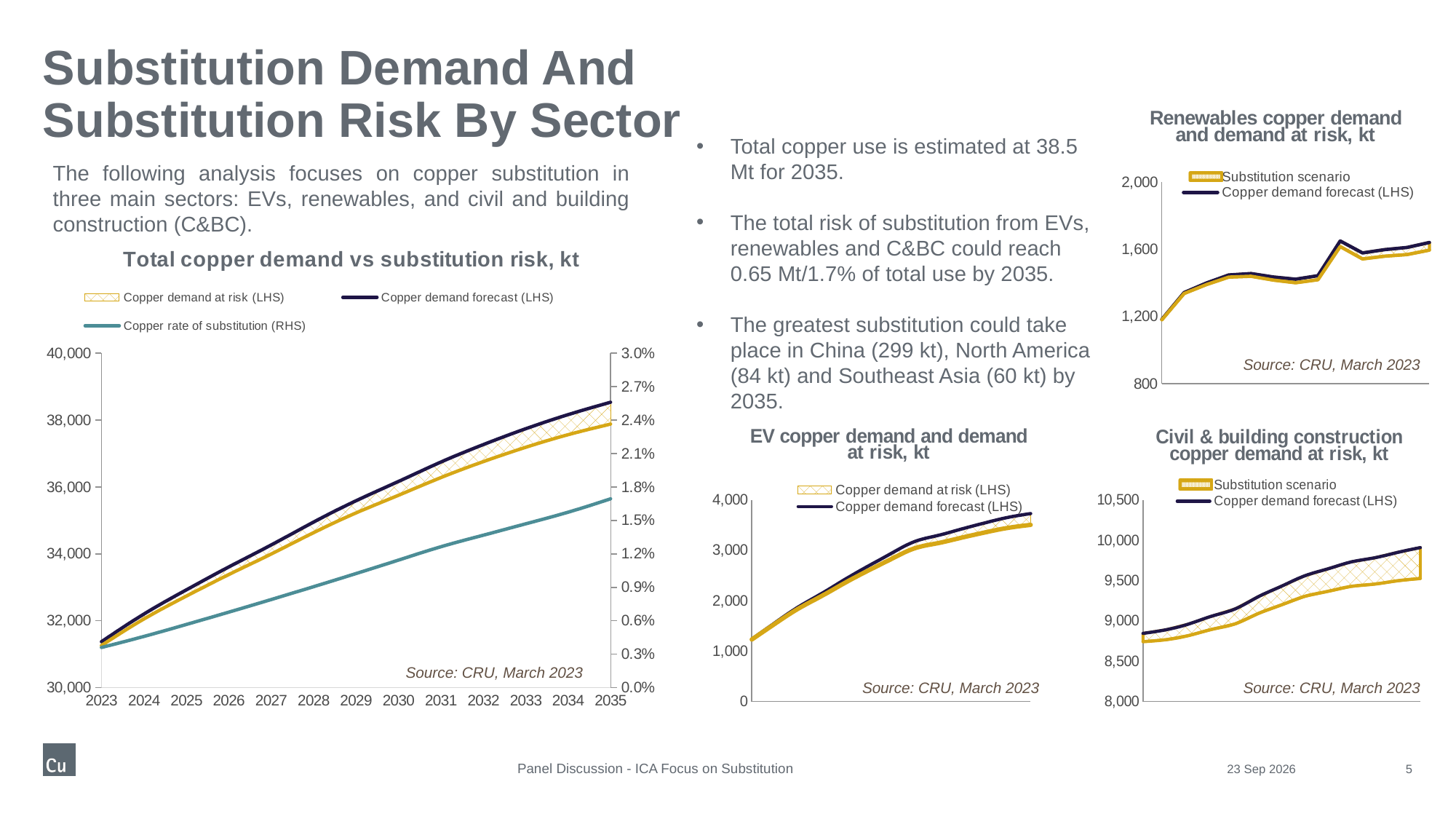
In 'Civil & building construction copper demand at risk, kt', is the copper demand forecast at the start of the period greater or less than 9,000? less In 'Total copper demand vs substitution risk, kt', which is higher in 2035: copper demand forecast or copper demand at risk? Copper demand forecast Which series is shown in yellow in 'Civil & building construction copper demand at risk, kt'? Substitution scenario In 'Total copper demand vs substitution risk, kt', is the copper rate of substitution in 2035 greater or less than 1.5%? greater What type of chart is 'Total copper demand vs substitution risk, kt'? Line chart In 'EV copper demand and demand at risk, kt', do the values rise or fall over the period? Rise In 'Total copper demand vs substitution risk, kt', does the copper demand forecast rise or fall from 2023 to 2035? Rise In 'EV copper demand and demand at risk, kt', is the copper demand forecast at the end of the period greater or less than 3,000? greater How many years are shown on the x axis of 'Total copper demand vs substitution risk, kt'? 13 How many series does the legend of 'Renewables copper demand and demand at risk, kt' list? 2 How many series does the legend of 'Total copper demand vs substitution risk, kt' list? 3